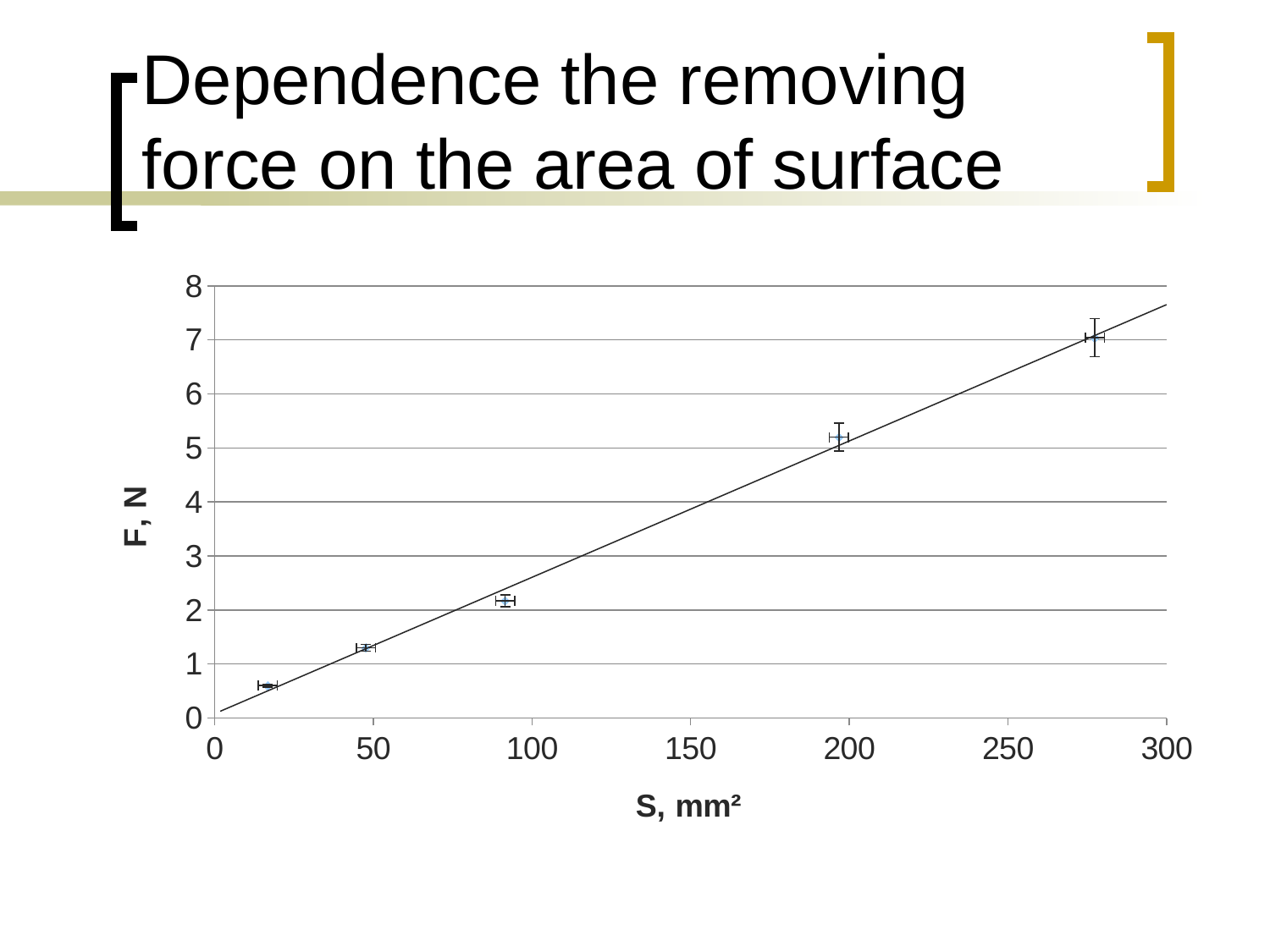
Which data point has the highest F value: the one near S = 200 or the one near S = 275? The one near S = 275 Is the F value of the data point with the largest S greater or less than 6? greater Is the F value of the data point with the smallest S greater or less than 1? less Is the F value of the data point near S = 50 greater or less than 2? less Do the values of F rise or fall as S increases along the x axis? Rise What is the label of the horizontal axis? S, mm² What is the maximum value shown on the vertical axis? 8 How many data points are plotted on the chart? 5 What kind of chart is shown on the slide? Scatter chart What is the label of the vertical axis? F, N